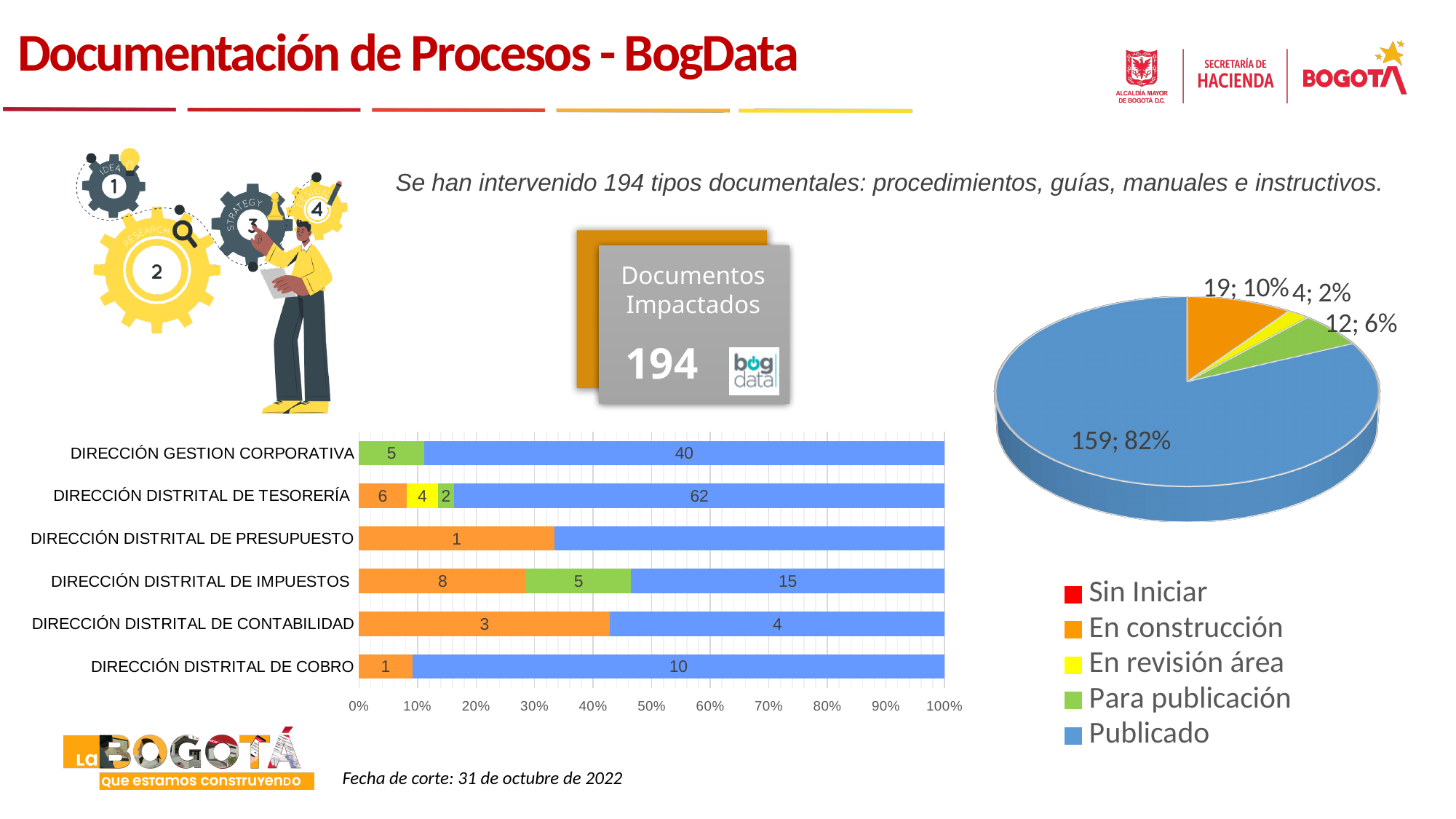
In the bar chart, what is the total of the labelled segments for DIRECCIÓN DISTRITAL DE TESORERÍA? 74 In the bar chart, how many direcciones (categories) are shown? 6 In the bar chart, what is the total of the labelled segments for DIRECCIÓN DISTRITAL DE IMPUESTOS? 28 In the bar chart, what is the Para publicación value for DIRECCIÓN GESTION CORPORATIVA? 5 In the bar chart, what is the Publicado value for DIRECCIÓN DISTRITAL DE COBRO? 10 In the bar chart, what is the En construcción value for DIRECCIÓN DISTRITAL DE IMPUESTOS? 8 In the pie chart, what share does the Publicado slice have? 82% In the bar chart, what is the Publicado value for DIRECCIÓN DISTRITAL DE TESORERÍA? 62 What kind of chart is the chart on the left of the slide? Stacked bar chart In the pie chart, which slice is the largest? Publicado (159; 82%) How many series does the legend list? 5 In the bar chart, what is the difference between the Publicado values for DIRECCIÓN DISTRITAL DE TESORERÍA and DIRECCIÓN GESTION CORPORATIVA? 22